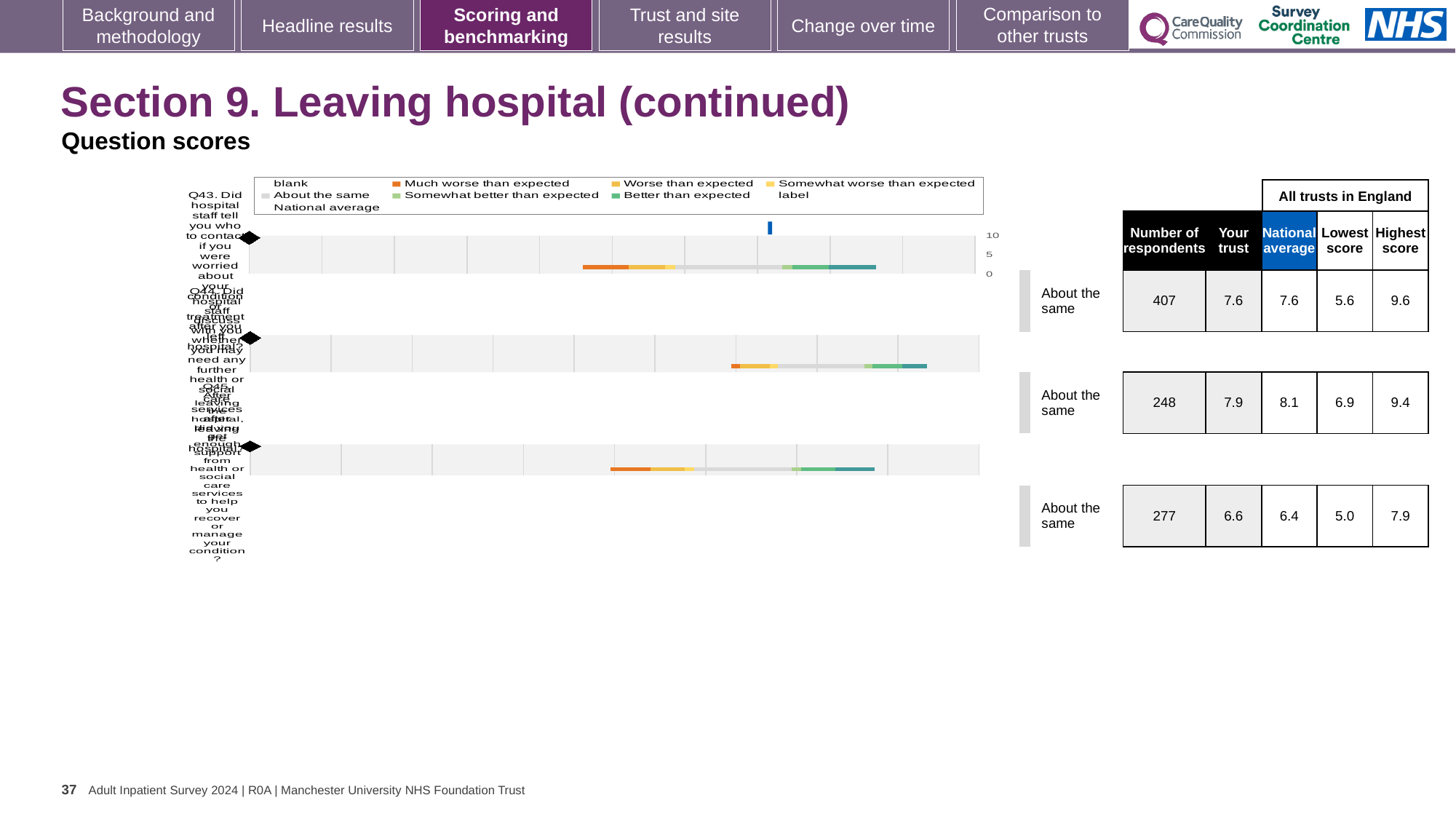
Which of the three questions has the highest 'Your trust' score in the table? Q44 What kind of chart is used for the question scores on this slide? bar chart In the table beside the third chart (Q45), what is the highest score among all trusts in England? 7.9 What benchmark category label is shown beside each of the three charts? About the same In the table beside the third chart (Q45), what is the lowest score among all trusts in England? 5.0 Which of the three questions has the lowest 'Your trust' score in the table? Q45 For the second chart (Q44), which is larger: the 'Your trust' score or the national average? National average In the table beside the first chart (Q43), what is the 'Your trust' score? 7.6 How many question-score charts are shown on the slide? 3 In the table beside the first chart (Q43), what is the number of respondents? 407 For the third chart (Q45), what is the difference between the 'Your trust' score and the national average? 0.2 In the table beside the second chart (Q44), what is the national average score? 8.1